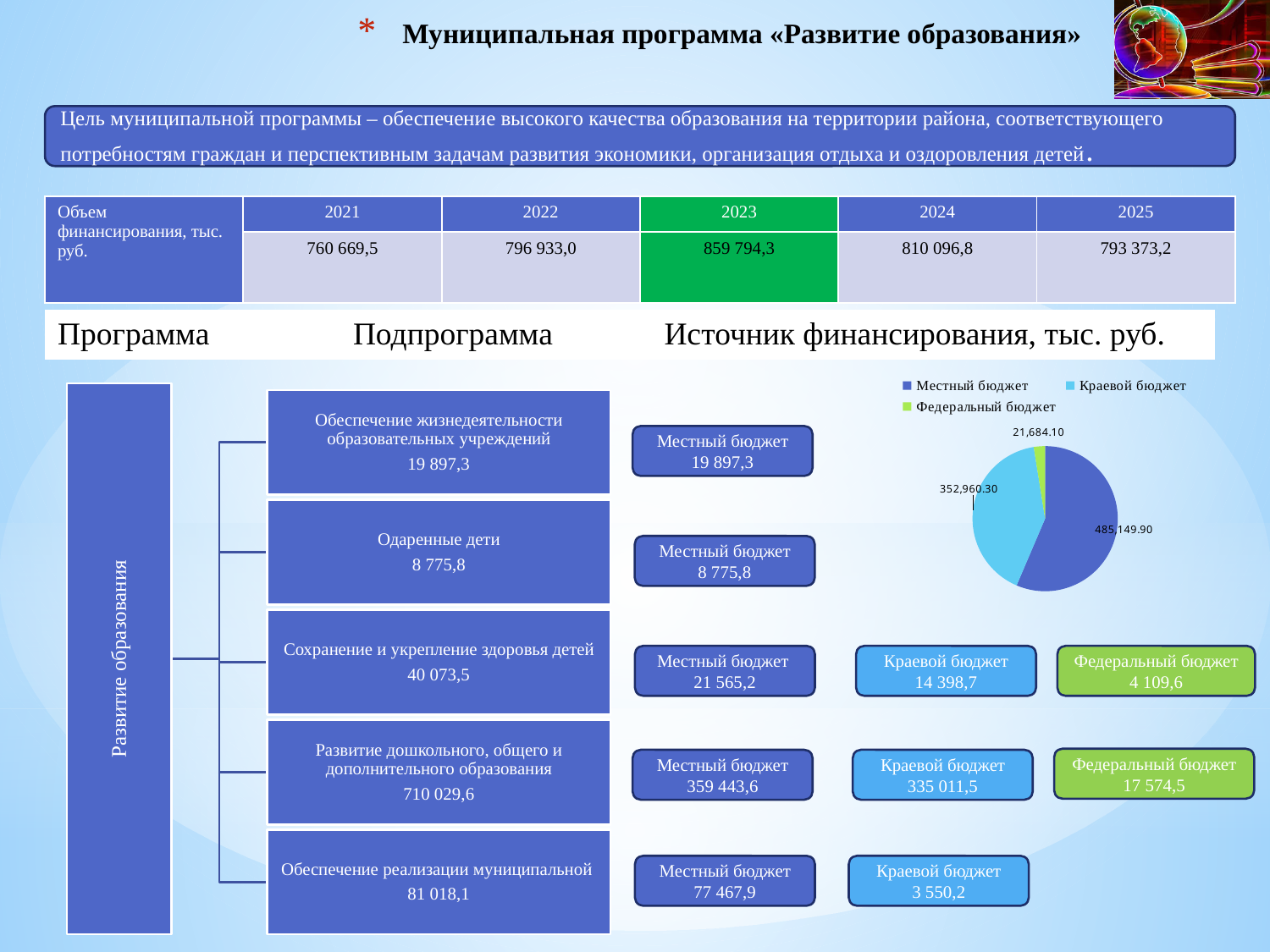
What is the total of all three slices in the pie chart? 859,794.30 Which slice of the pie chart is the largest? Местный бюджет In the pie chart, what is the difference between Краевой бюджет and Федеральный бюджет? 331,276.20 What kind of chart is shown on the right side of the slide? pie chart In the pie chart, what is the value for Краевой бюджет? 352,960.30 Which slice of the pie chart is the smallest? Федеральный бюджет In the pie chart, what is the value for Федеральный бюджет? 21,684.10 In the pie chart, which is larger: Краевой бюджет or Федеральный бюджет? Краевой бюджет In the pie chart, what is the value for Местный бюджет? 485,149.90 How many entries does the pie chart's legend list? 3 In the pie chart, what is the difference between Местный бюджет and Краевой бюджет? 132,189.60 How many slices does the pie chart have? 3